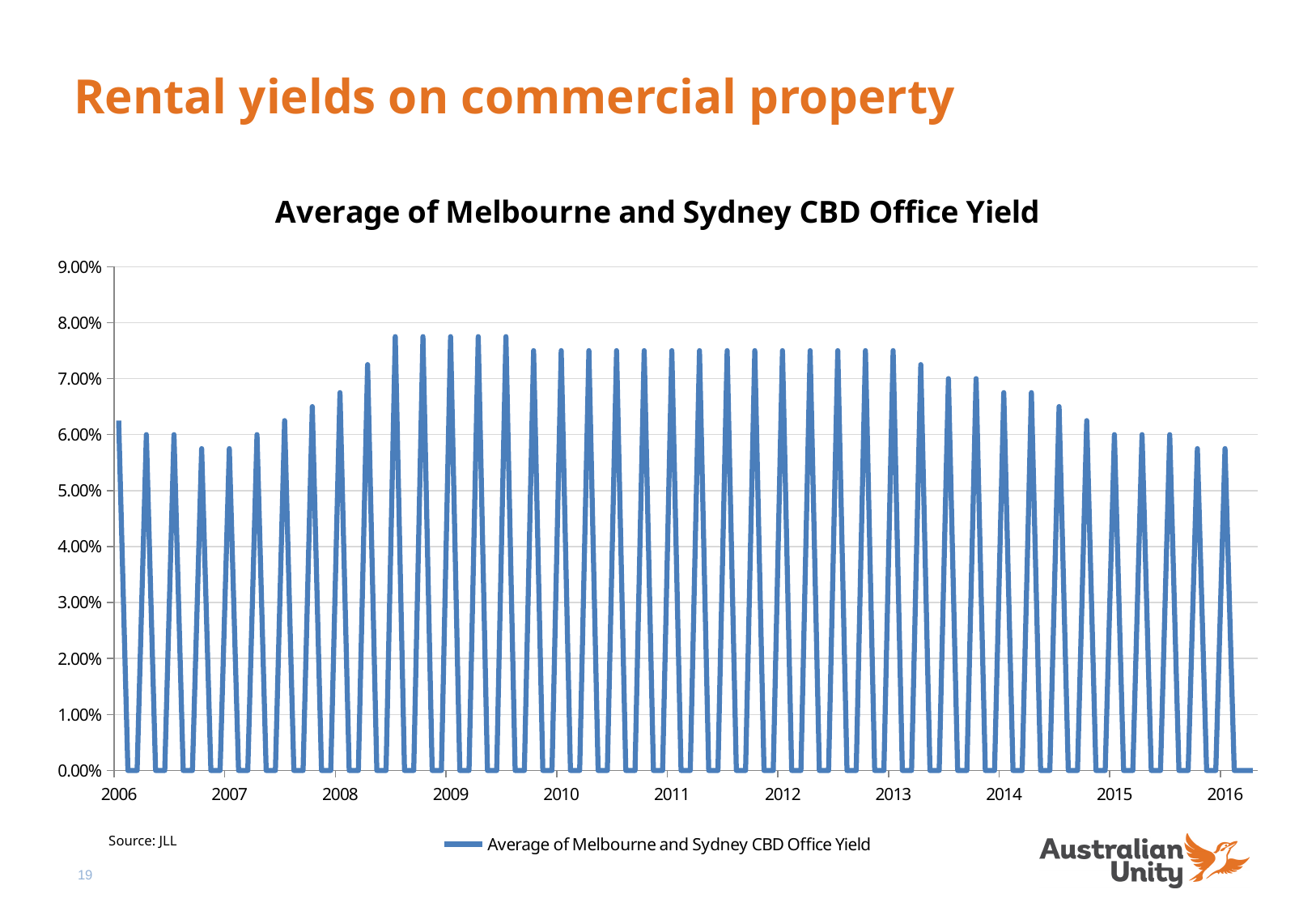
How many series does the legend list? 1 What is the source cited for the chart? JLL Is the peak value at the start of 2016 greater or less than 6.00%? less What is the title of the chart? Average of Melbourne and Sydney CBD Office Yield Is the peak value at the start of 2013 greater or less than 7.00%? greater Is the peak value at the start of 2014 greater or less than 7.00%? less Which is higher, the peak value at the start of 2009 or the peak value at the start of 2016? 2009 Do the peak values rise or fall between 2013 and 2016? fall Do the peak values rise or fall between 2007 and 2009? rise What kind of chart is shown on the slide? line chart How many year labels are shown on the x axis? 11